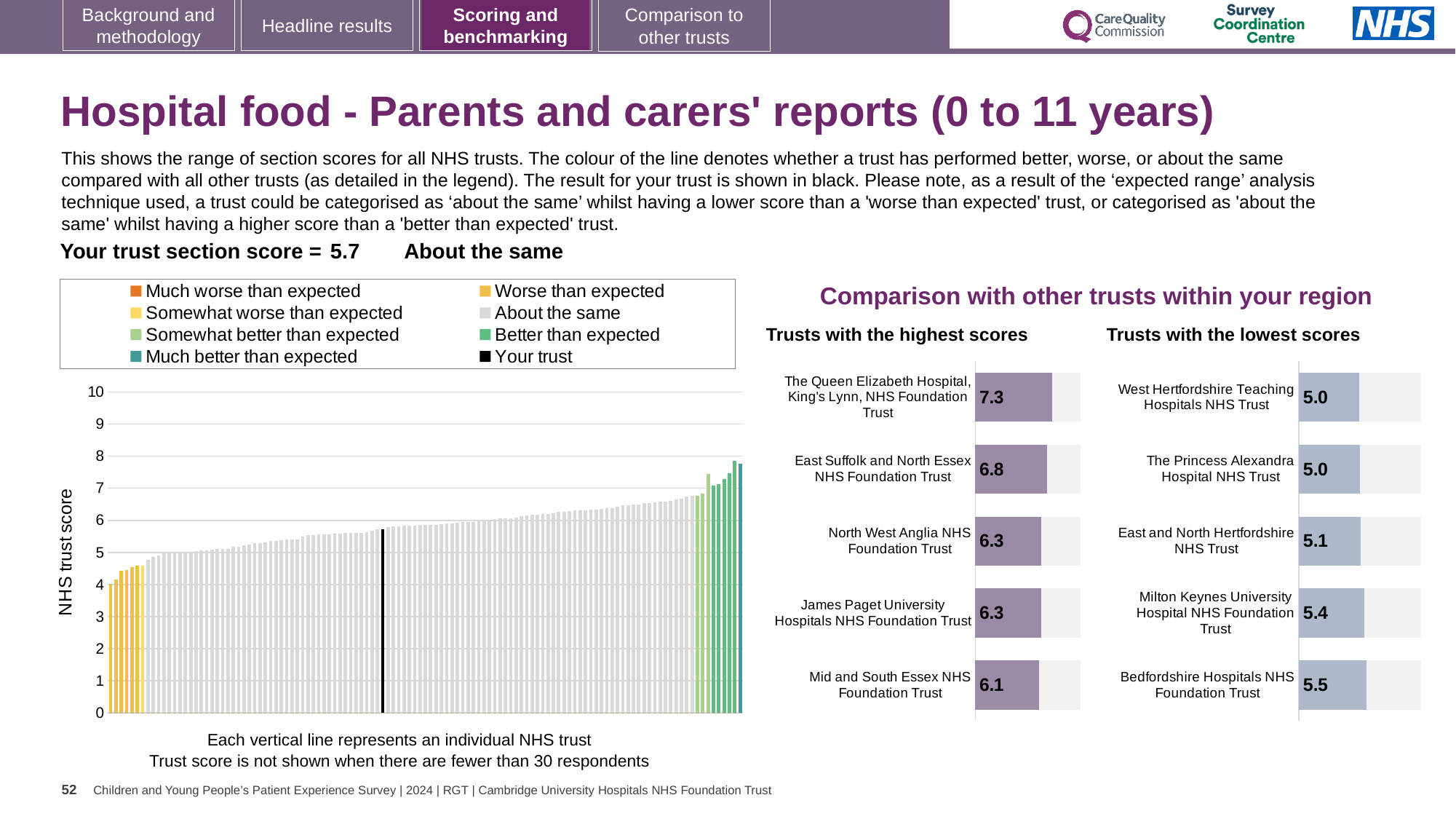
In the 'Trusts with the highest scores' chart, which trust has the highest score? The Queen Elizabeth Hospital, King's Lynn, NHS Foundation Trust In the main chart on the left, is the value of the shortest bar greater or less than 5? less In the 'Trusts with the lowest scores' chart, which trust has the highest score? Bedfordshire Hospitals NHS Foundation Trust What kind of chart is the main chart on the left of the slide? Bar chart In the main chart on the left, is the value of the tallest bar greater or less than 7? greater In the main chart on the left, what is the section score for your trust (the black bar)? 5.7 In the 'Trusts with the highest scores' chart, what is the score for The Queen Elizabeth Hospital, King's Lynn, NHS Foundation Trust? 7.3 How many trusts are shown in the 'Trusts with the highest scores' chart? 5 In the 'Trusts with the lowest scores' chart, what is the score for Milton Keynes University Hospital NHS Foundation Trust? 5.4 In the 'Trusts with the highest scores' chart, what is the difference between the scores of The Queen Elizabeth Hospital, King's Lynn and East Suffolk and North Essex NHS Foundation Trust? 0.5 In the 'Trusts with the lowest scores' chart, which has the larger score: East and North Hertfordshire NHS Trust or Bedfordshire Hospitals NHS Foundation Trust? Bedfordshire Hospitals NHS Foundation Trust How many entries does the legend of the main chart on the left list? 8